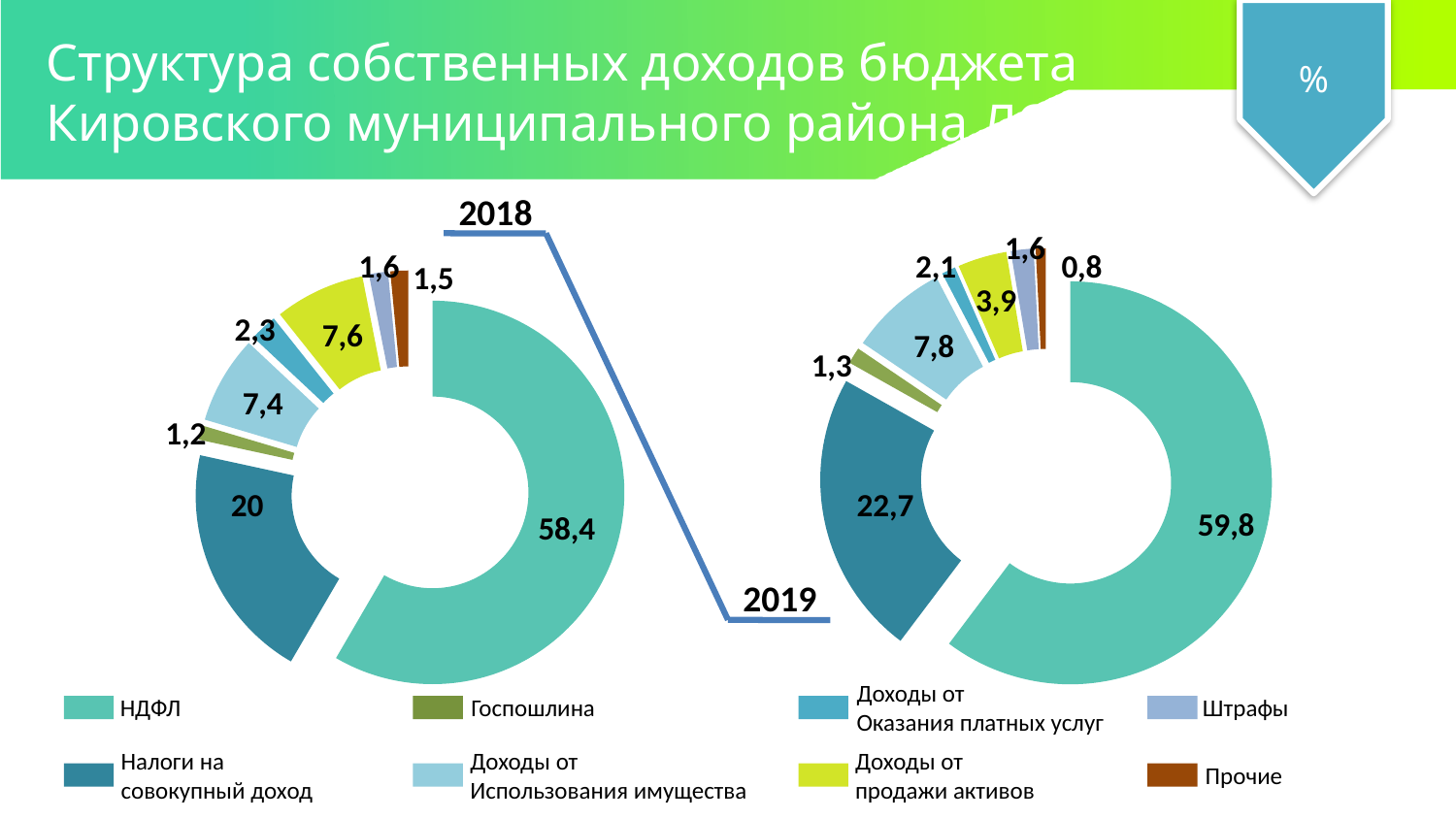
In the legend, which category is shown in brown? Прочие In the 2018 chart, what is the value for НДФЛ? 58,4 What type of chart is used for the 2018 and 2019 data? Doughnut chart How many categories does the legend list? 8 In the 2019 chart, what is the difference between Налоги на совокупный доход and Доходы от использования имущества? 14,9 In the 2018 chart, which is larger: Доходы от продажи активов or Доходы от использования имущества? Доходы от продажи активов In the 2019 chart, what is the value for Доходы от продажи активов? 3,9 What is the difference between the НДФЛ value in the 2019 chart and the НДФЛ value in the 2018 chart? 1,4 In the 2018 chart, what is the value for Доходы от использования имущества? 7,4 In the 2019 chart, what is the value for Налоги на совокупный доход? 22,7 In the 2019 chart, which category has the smallest value? Прочие In the 2018 chart, which category has the largest value? НДФЛ